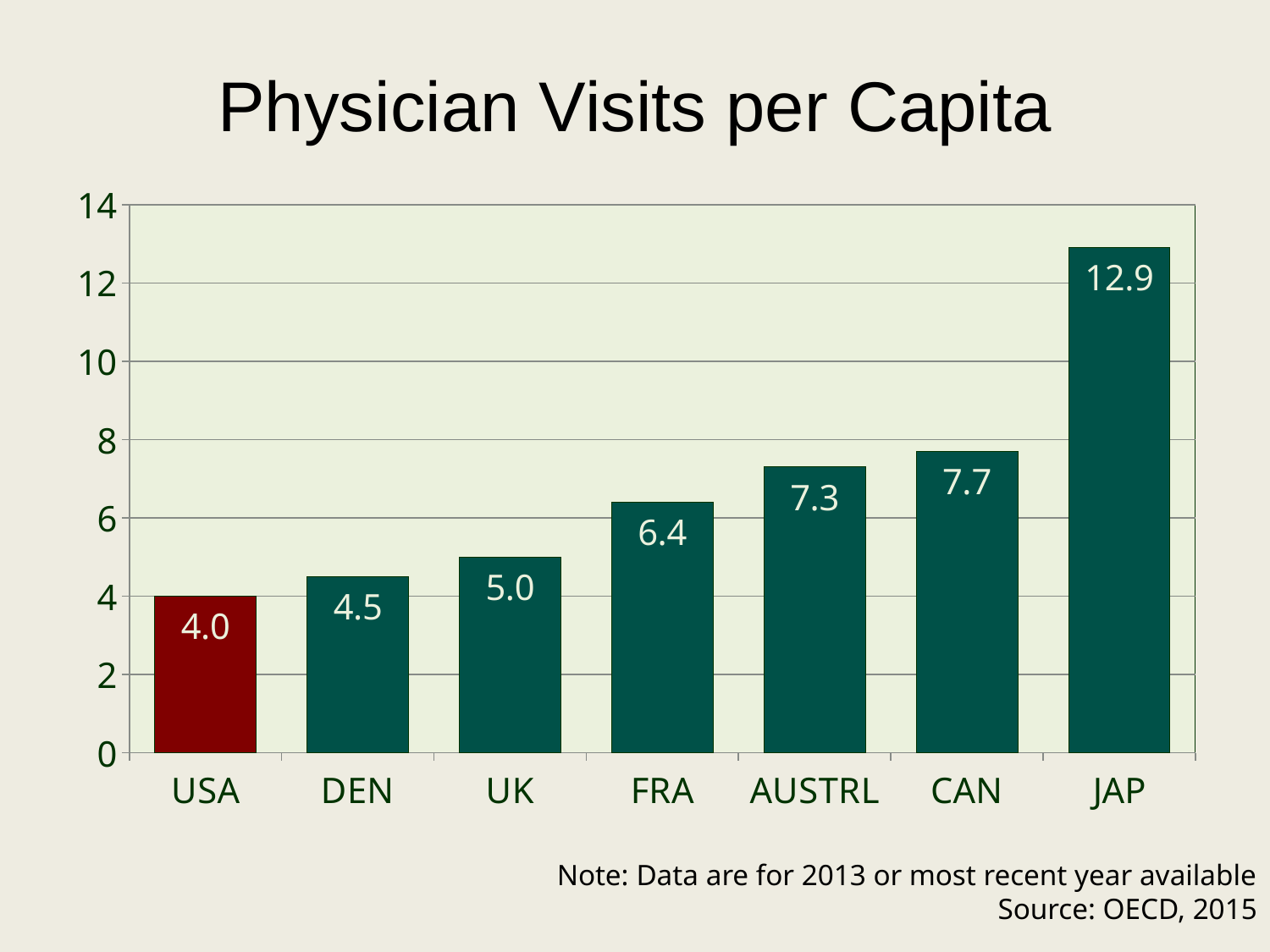
How many countries are shown on the chart? 7 What is the value for JAP? 12.9 Which bar is coloured differently from the others? USA What is the value for AUSTRL? 7.3 What is the difference between the values for UK and USA? 1.0 What is the value for USA? 4.0 What kind of chart is this? bar chart Which is larger, the value for FRA or the value for DEN? FRA Which country has the lowest physician visits per capita? USA Which country has the highest physician visits per capita? JAP What is the difference between the values for JAP and CAN? 5.2 Is the value for CAN greater or less than 8? less